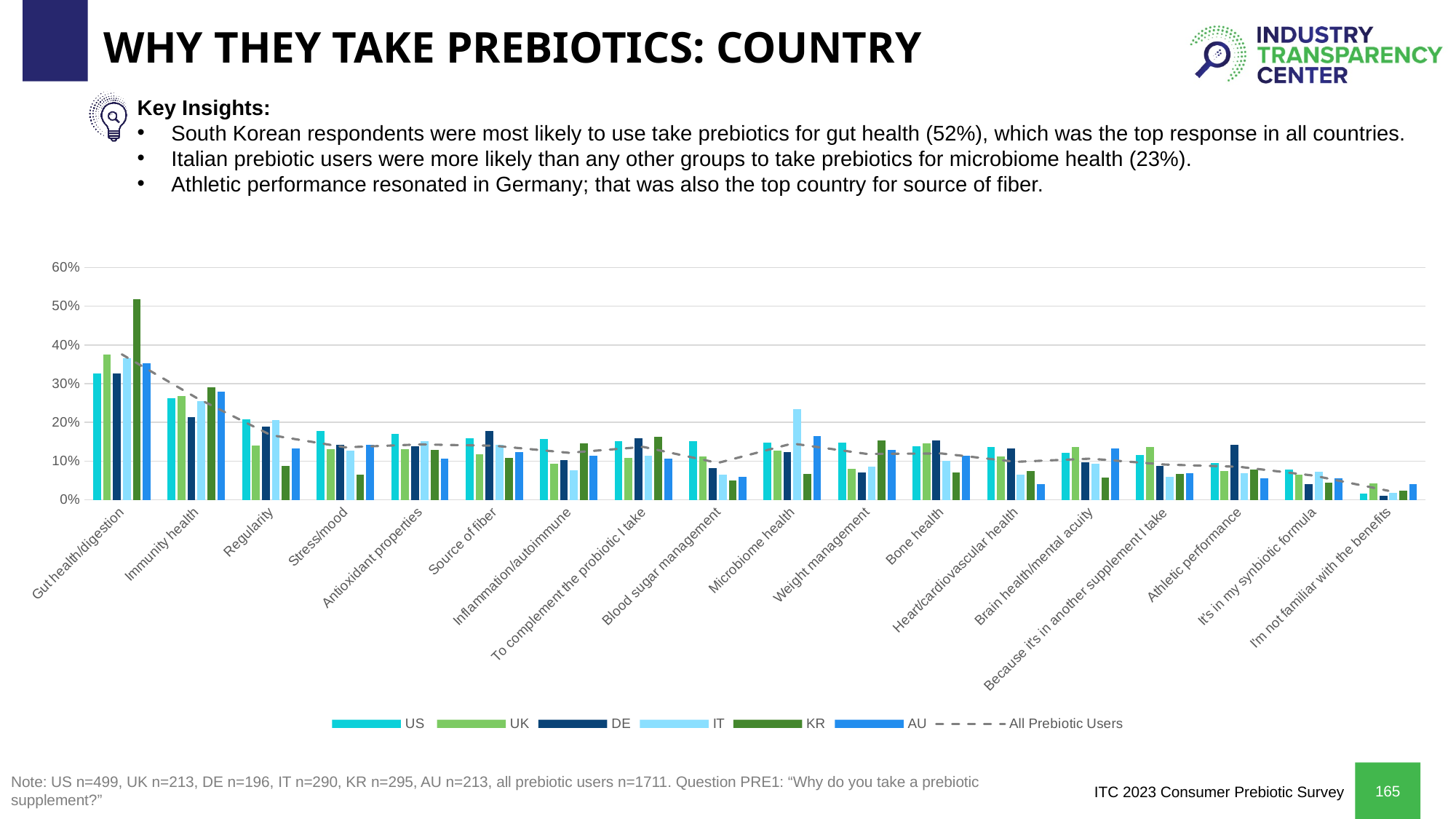
Which is larger for Microbiome health, the IT bar or the US bar? IT Is the KR value for Gut health/digestion greater or less than 50%? greater Which category has the highest values overall? Gut health/digestion How many reason categories are shown along the x axis? 18 What kind of chart is shown on the slide? combination bar and line chart Which category has the lowest values overall? I'm not familiar with the benefits Which series is shown as a dashed line rather than bars? All Prebiotic Users Do the values for All Prebiotic Users generally rise or fall from left to right along the x axis? fall Is the UK value for Regularity greater or less than 20%? less Is the IT value for Microbiome health greater or less than 20%? greater How many series does the legend list? 7 Which country has the highest bar for Gut health/digestion? KR